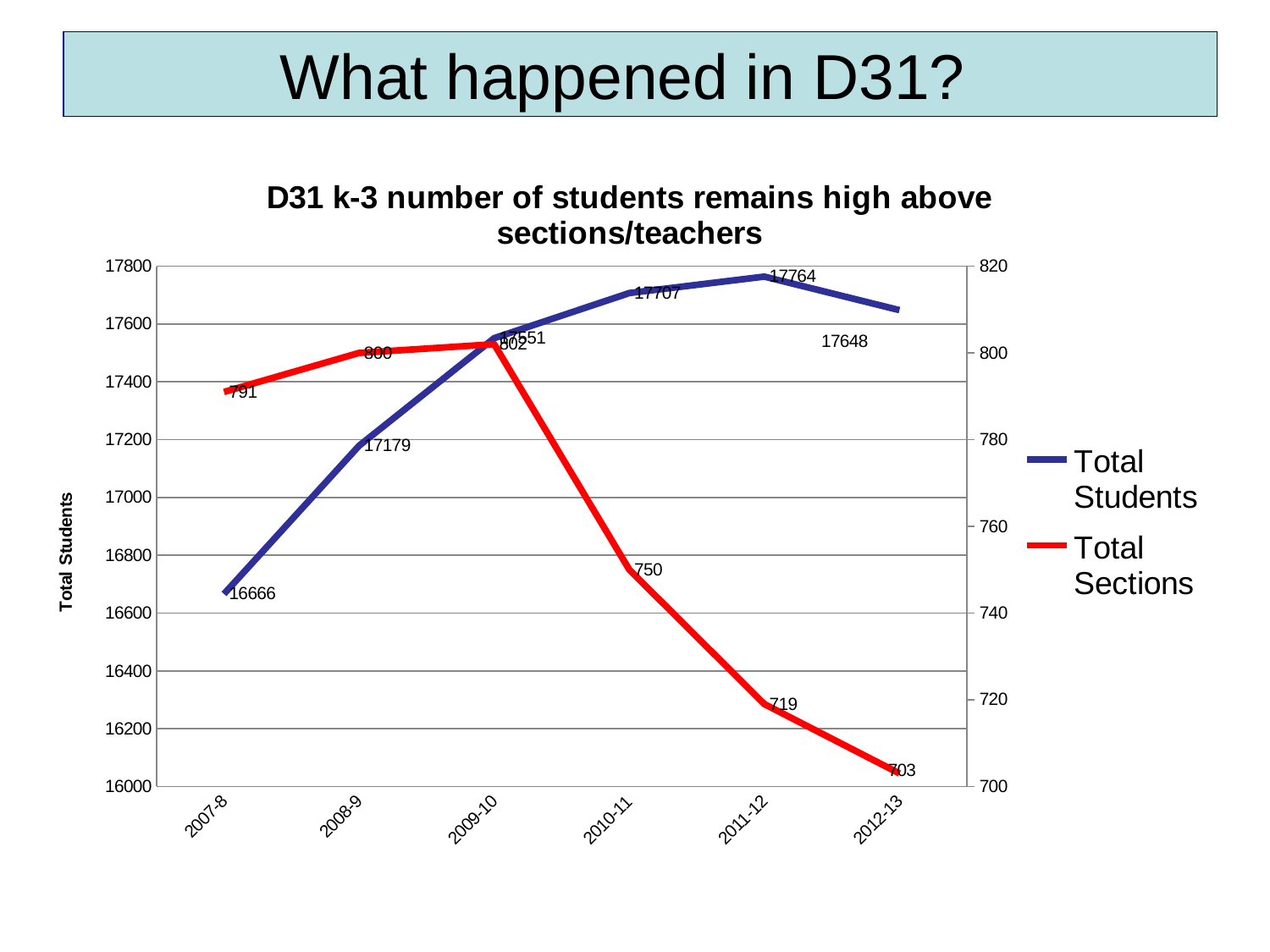
How many series does the legend list? 2 What is the Total Sections value for 2012-13? 703 How many school years are plotted on the x axis? 6 In which school year is Total Students highest? 2011-12 What is the Total Sections value for 2010-11? 750 What is the difference between Total Students in 2011-12 and 2007-8? 1098 Is Total Sections larger in 2008-9 or in 2011-12? 2008-9 In which school year is Total Sections lowest? 2012-13 Does Total Sections rise or fall from 2009-10 to 2012-13? fall What is the Total Students value for 2007-8? 16666 What is the Total Students value for 2011-12? 17764 What type of chart is shown on the slide? line chart